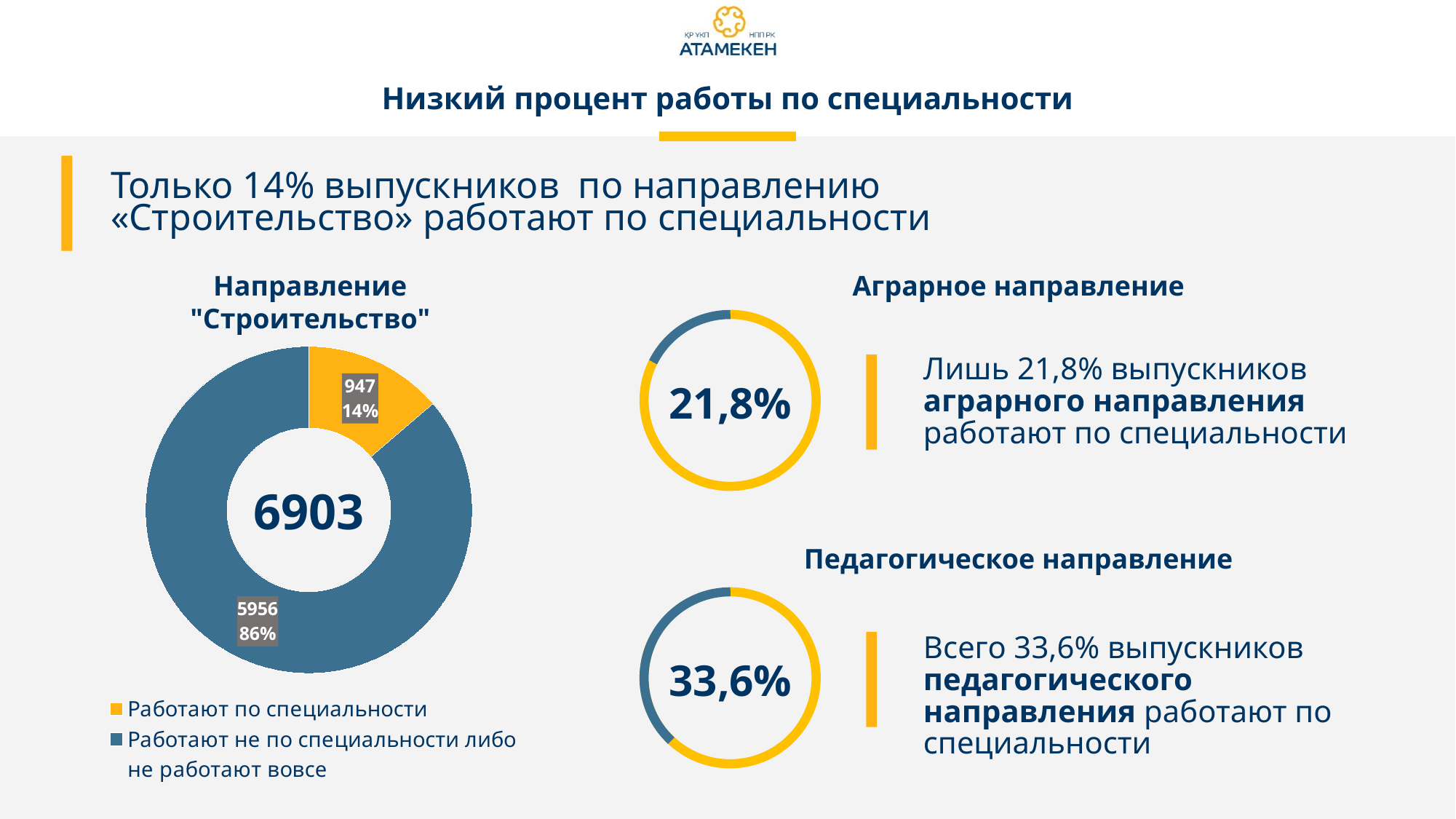
In the chart titled Направление "Строительство", what percentage share does Работают по специальности have? 14% In the chart titled Направление "Строительство", which category is the largest? Работают не по специальности либо не работают вовсе In the chart titled Направление "Строительство", how many categories does the legend list? 2 In the chart titled Направление "Строительство", what is the value for Работают по специальности? 947 In the chart titled Направление "Строительство", what is the difference between the two categories' values? 5009 In the chart titled Направление "Строительство", which category is the smallest? Работают по специальности In the chart titled Направление "Строительство", what is the total shown in the centre of the donut? 6903 In the chart titled Педагогическое направление, what percentage is shown in the centre of the ring? 33,6% In the chart titled Аграрное направление, what percentage is shown in the centre of the ring? 21,8% In the chart titled Направление "Строительство", what is the value for Работают не по специальности либо не работают вовсе? 5956 What kind of chart is the one titled Направление "Строительство"? Donut (pie) chart In the chart titled Направление "Строительство", what percentage share does Работают не по специальности либо не работают вовсе have? 86%